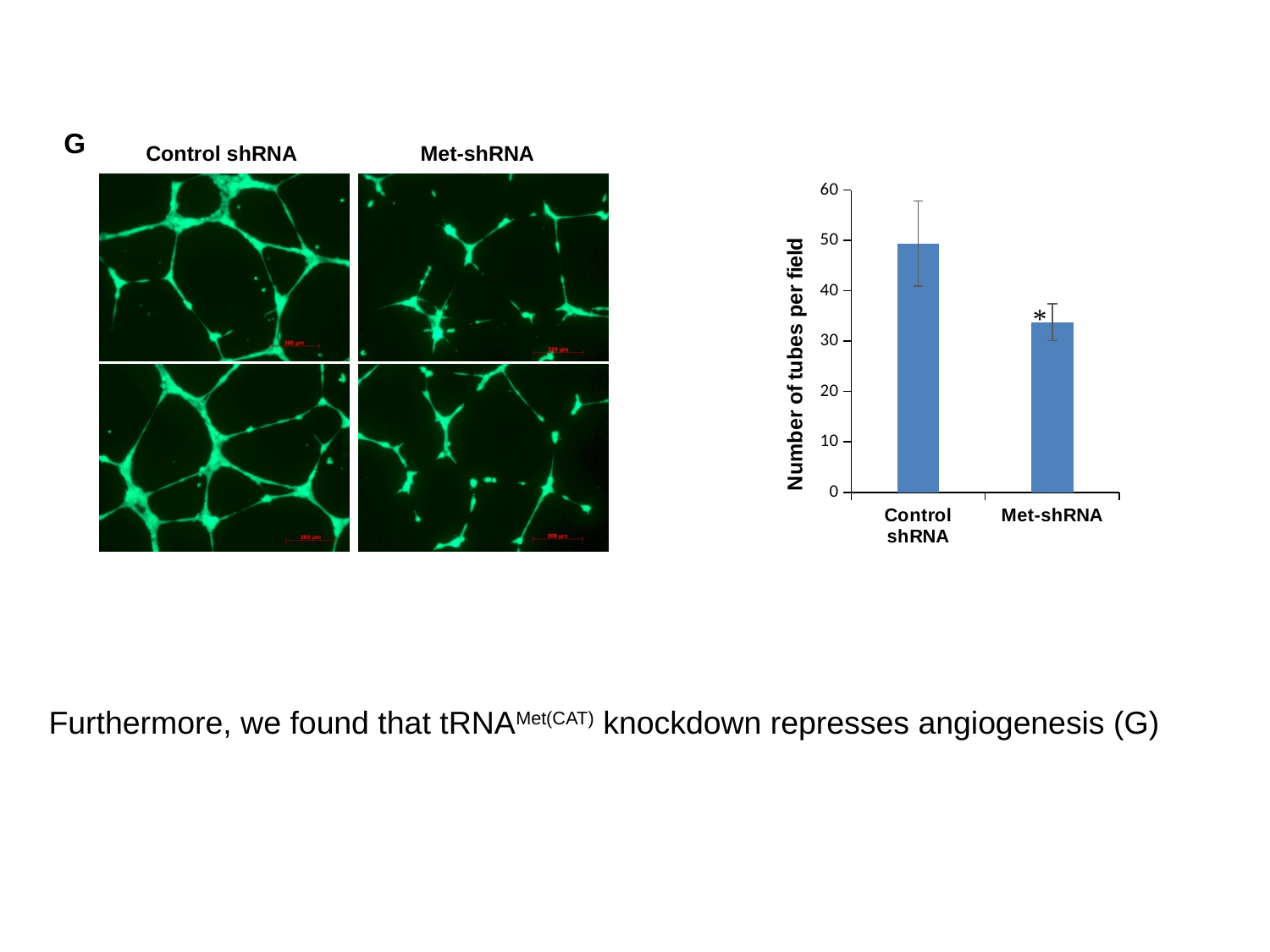
What is the title of the y axis of the bar chart? Number of tubes per field How many categories are plotted on the x axis of the bar chart? 2 Which is larger, the value for Control shRNA or the value for Met-shRNA? Control shRNA What kind of chart is shown on the slide? bar chart Which category has the lowest number of tubes per field? Met-shRNA Is the value for Met-shRNA greater or less than 30? greater Do the values rise or fall from Control shRNA to Met-shRNA along the x axis? fall Which bar in the chart is marked with an asterisk? Met-shRNA Is the value for Control shRNA greater or less than 60? less Which category has the highest number of tubes per field? Control shRNA Is the value for Control shRNA greater or less than 40? greater